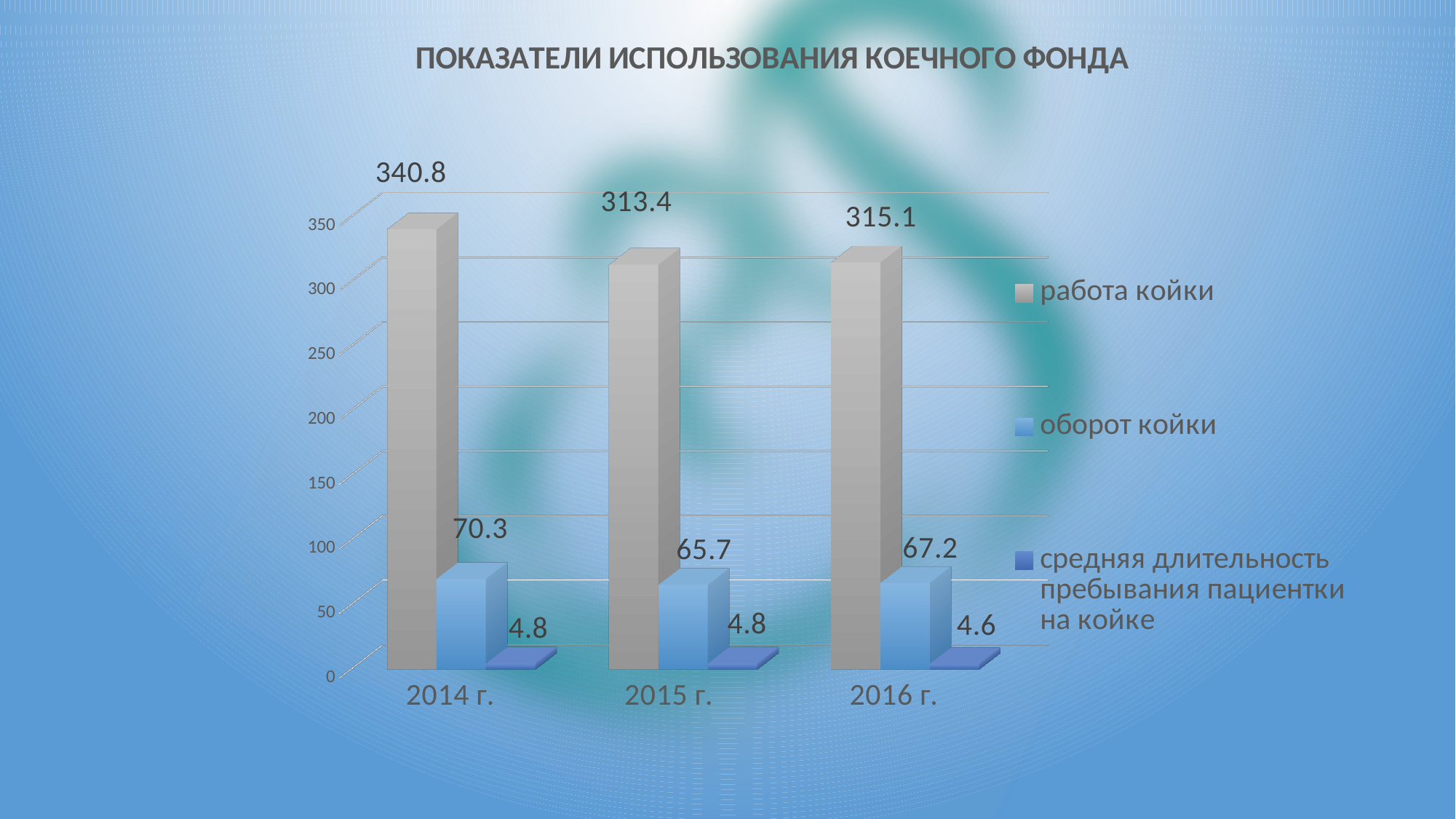
What is the difference between работа койки in 2014 г. and 2015 г.? 27.4 Which year has the highest value for работа койки? 2014 г. How many series does the legend list? 3 Does the value of средняя длительность пребывания пациентки на койке rise or fall from 2015 г. to 2016 г.? Fall What is the value of работа койки for 2014 г.? 340.8 What is the value of средняя длительность пребывания пациентки на койке for 2016 г.? 4.6 What is the title of the chart? ПОКАЗАТЕЛИ ИСПОЛЬЗОВАНИЯ КОЕЧНОГО ФОНДА Which year has the lowest value for оборот койки? 2015 г. How many years are shown on the x axis? 3 What is the value of оборот койки for 2015 г.? 65.7 Which is larger: оборот койки in 2014 г. or in 2016 г.? 2014 г. What kind of chart is shown on the slide? Bar chart